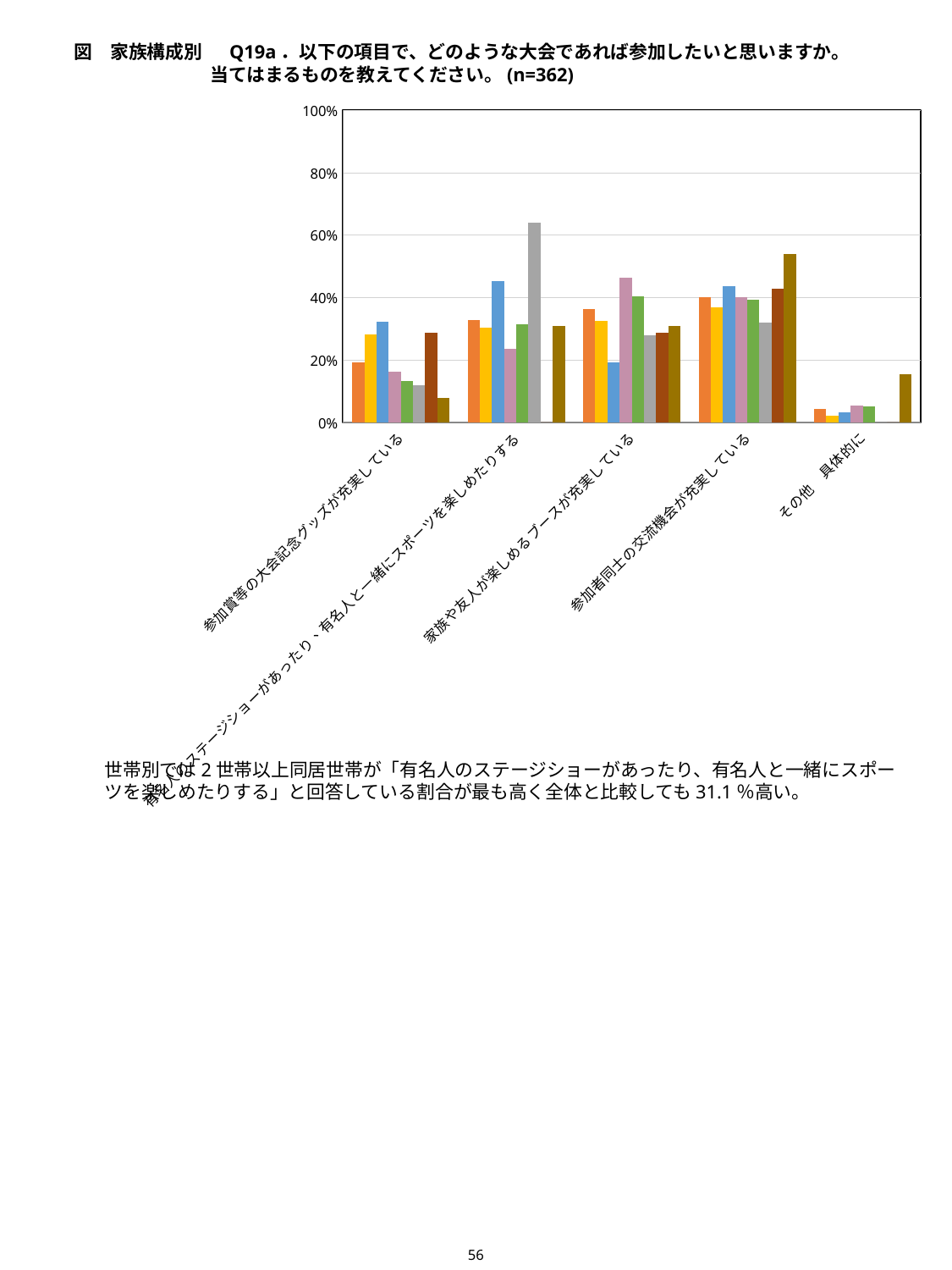
Is the tallest bar in the 家族や友人が楽しめるブースが充実している category greater or less than 60%? less What is the maximum value shown on the y axis of the chart? 100% Is the tallest bar in the 参加者同士の交流機会が充実している category greater or less than 40%? greater What kind of chart is shown on the slide? bar chart Which category has the lowest bars overall in the chart? その他 具体的に Which category contains the tallest bar in the chart? 有名人のステージショーがあったり、有名人と一緒にスポーツを楽しめたりする Is the tallest bar in the 有名人のステージショーがあったり、有名人と一緒にスポーツを楽しめたりする category greater or less than 60%? greater How many categories are shown along the x axis of the chart? 5 What sample size (n) is stated in the chart title? n=362